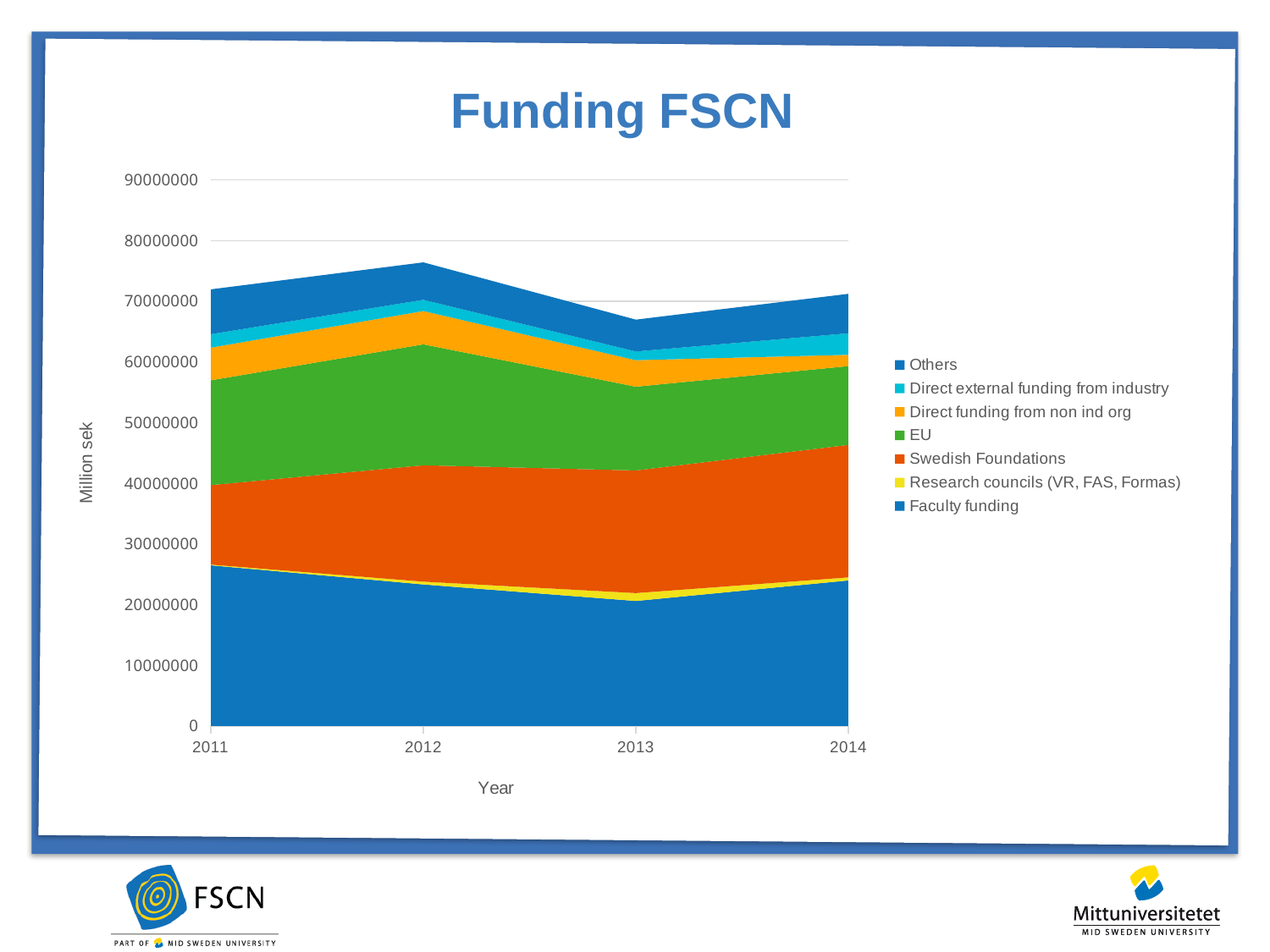
In which year is the total funding (top of the stacked area) lowest? 2013 Does the Faculty funding area rise or fall from 2011 to 2013? fall What kind of chart is shown on the slide? Stacked area chart Is the total funding in 2012 greater or less than 80000000? less In which year is the total funding (top of the stacked area) highest? 2012 How many years are shown on the x axis? 4 What is the title of the chart? Funding FSCN Is the total funding in 2011 greater or less than 70000000? greater Is the Faculty funding value in 2011 greater or less than 20000000? greater How many series does the legend list? 7 What is the label of the vertical axis? Million sek